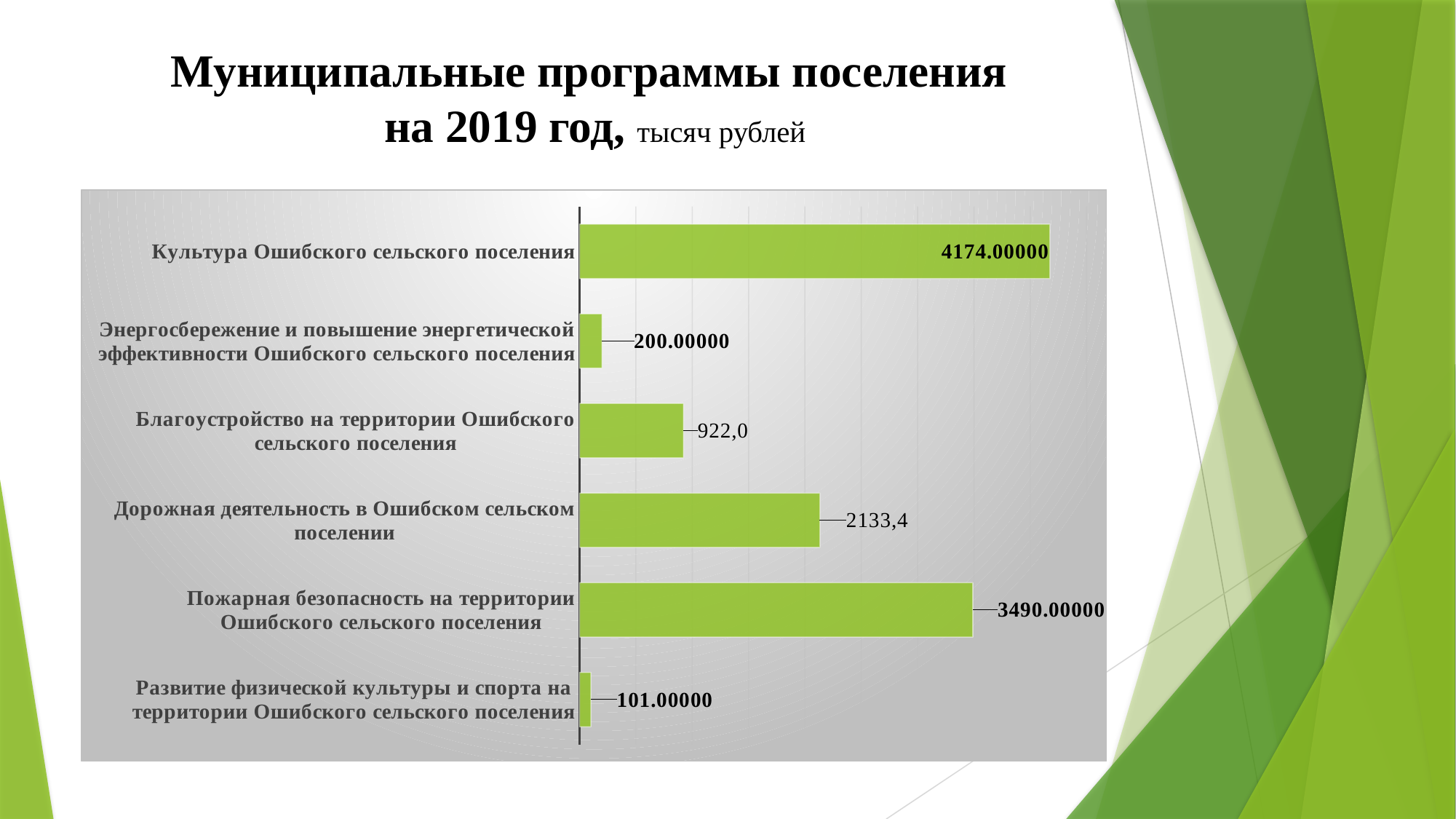
What is the difference between the values for Энергосбережение и повышение энергетической эффективности Ошибского сельского поселения and Развитие физической культуры и спорта на территории Ошибского сельского поселения? 99 What kind of chart is shown on the slide? Bar chart Which category has the highest value? Культура Ошибского сельского поселения What is the value for Пожарная безопасность на территории Ошибского сельского поселения? 3490.00000 What is the difference between the values for Культура Ошибского сельского поселения and Пожарная безопасность на территории Ошибского сельского поселения? 684 What is the value for Культура Ошибского сельского поселения? 4174.00000 Which is larger: the value for Дорожная деятельность в Ошибском сельском поселении or the value for Благоустройство на территории Ошибского сельского поселения? Дорожная деятельность в Ошибском сельском поселении How many categories are shown in the chart? 6 What is the value for Дорожная деятельность в Ошибском сельском поселении? 2133,4 What is the value for Благоустройство на территории Ошибского сельского поселения? 922,0 Which category has the lowest value? Развитие физической культуры и спорта на территории Ошибского сельского поселения What unit is stated in the slide title for the values? тысяч рублей